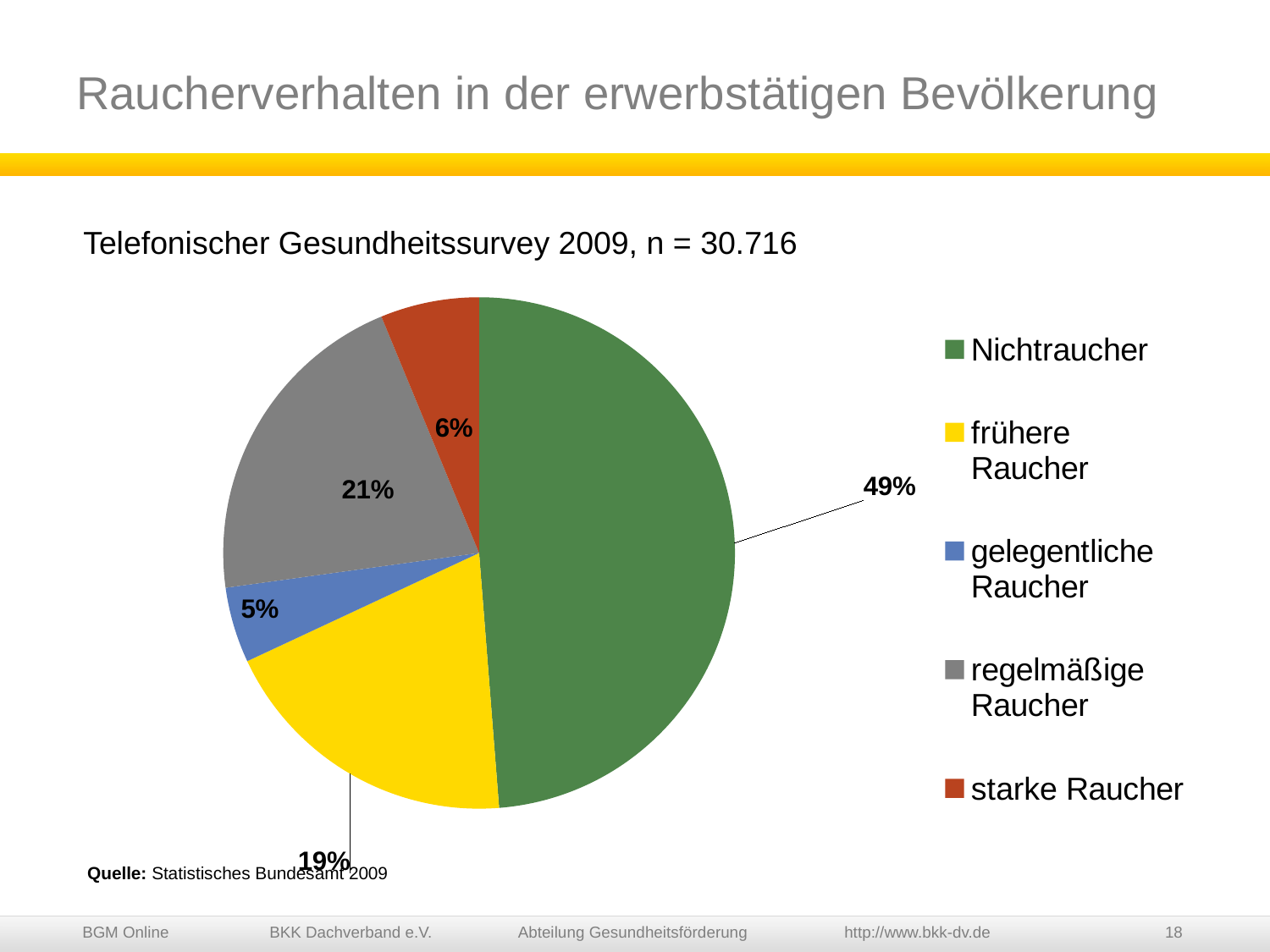
What share of the pie is gelegentliche Raucher? 5% What share of the pie is starke Raucher? 6% Which is larger, the share for regelmäßige Raucher or the share for frühere Raucher? regelmäßige Raucher What is the difference in percentage points between regelmäßige Raucher and frühere Raucher? 2% What colour is the slice for Nichtraucher? green What share of the pie is frühere Raucher? 19% Which category has the smallest slice of the pie? gelegentliche Raucher How many categories does the legend list? 5 Which category has the largest slice of the pie? Nichtraucher What kind of chart is shown on the slide? pie chart